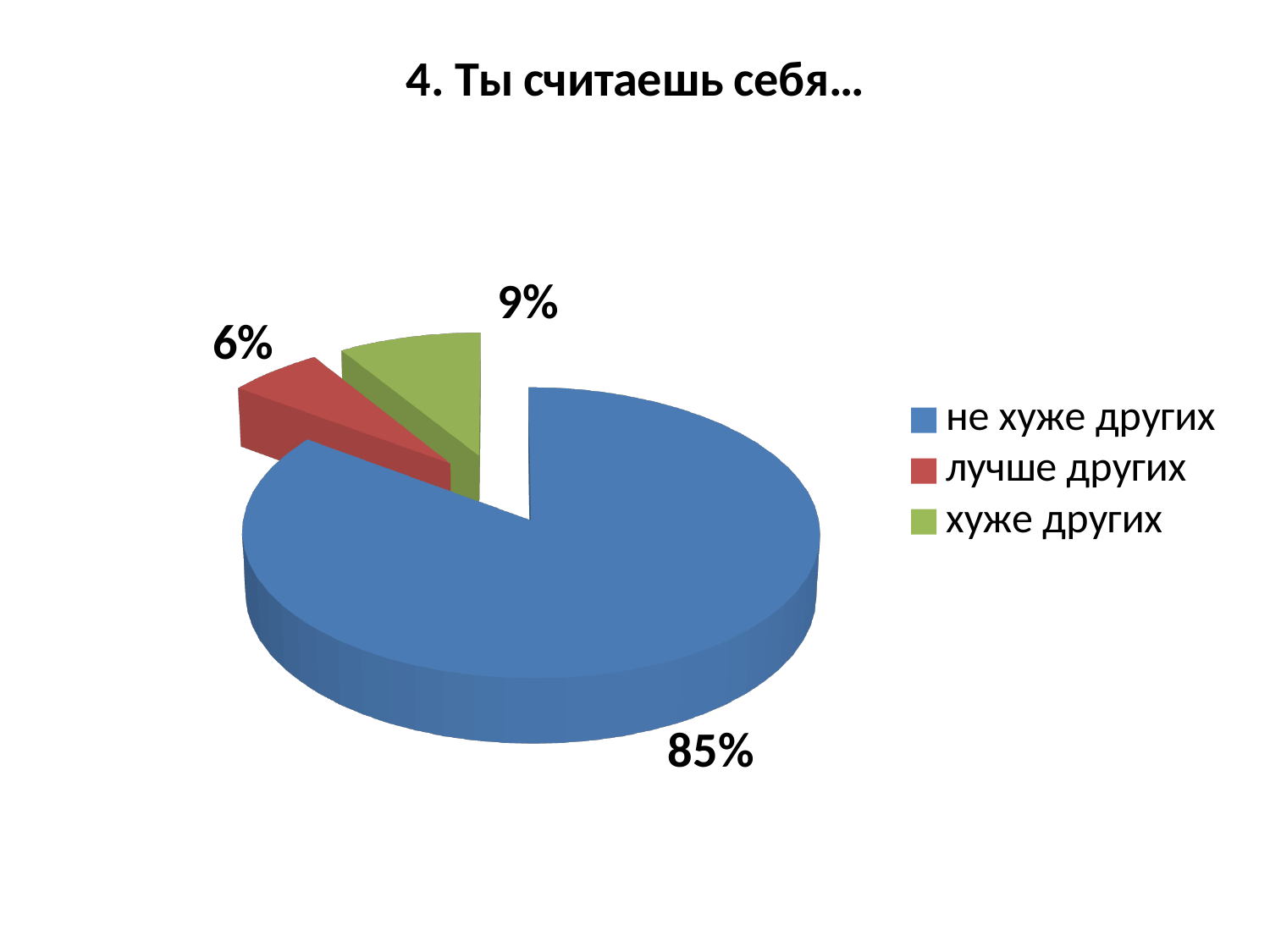
What is the difference in percentage points between "не хуже других" and "хуже других"? 76 What percentage of respondents answered "хуже других"? 9% What percentage of respondents answered "лучше других"? 6% What is the title of the chart? 4. Ты считаешь себя… Which is larger: the share for "хуже других" or the share for "лучше других"? хуже других What kind of chart is shown on the slide? pie chart How many slices does the pie chart have? 3 What is the difference in percentage points between "хуже других" and "лучше других"? 3 Which answer option has the smallest share of the pie? лучше других What colour is the slice for "лучше других"? red Which answer option has the largest share of the pie? не хуже других What percentage of respondents answered "не хуже других"? 85%